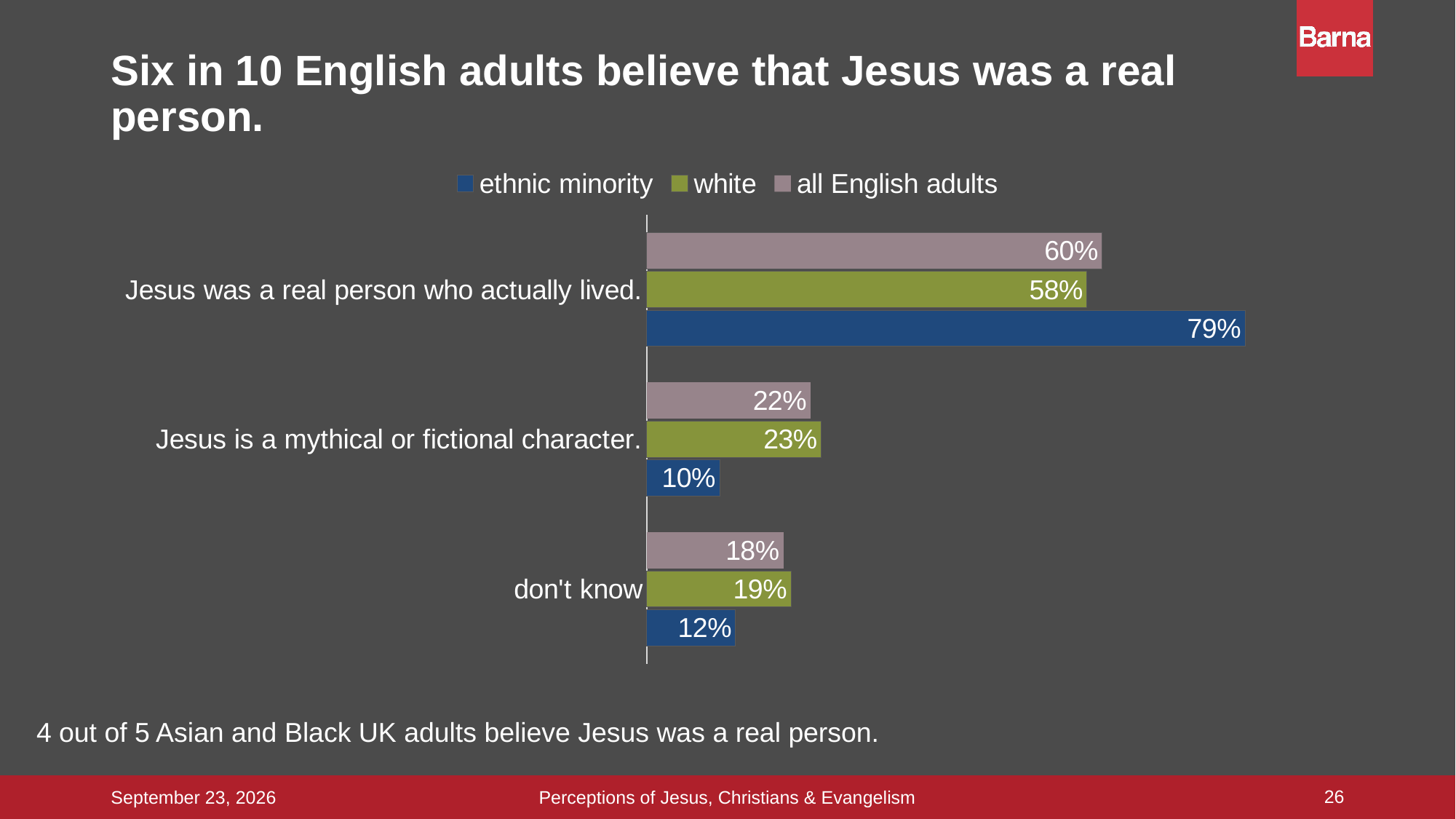
What percentage of white adults answered "don't know"? 19% Which is larger: the all English adults value for "don't know" or the ethnic minority value for "don't know"? all English adults What is the difference between the white and ethnic minority values for "Jesus is a mythical or fictional character"? 13% Which group has the lowest value for "Jesus is a mythical or fictional character"? ethnic minority What percentage of ethnic minority adults believe Jesus was a real person who actually lived? 79% What kind of chart is shown on the slide? bar chart Which group has the highest value for "Jesus was a real person who actually lived"? ethnic minority What percentage of all English adults say Jesus is a mythical or fictional character? 22% How many response categories are shown on the chart? 3 What is the difference between the ethnic minority and white values for "Jesus was a real person who actually lived"? 21% How many series does the legend list? 3 Which series is shown in green in the legend? white